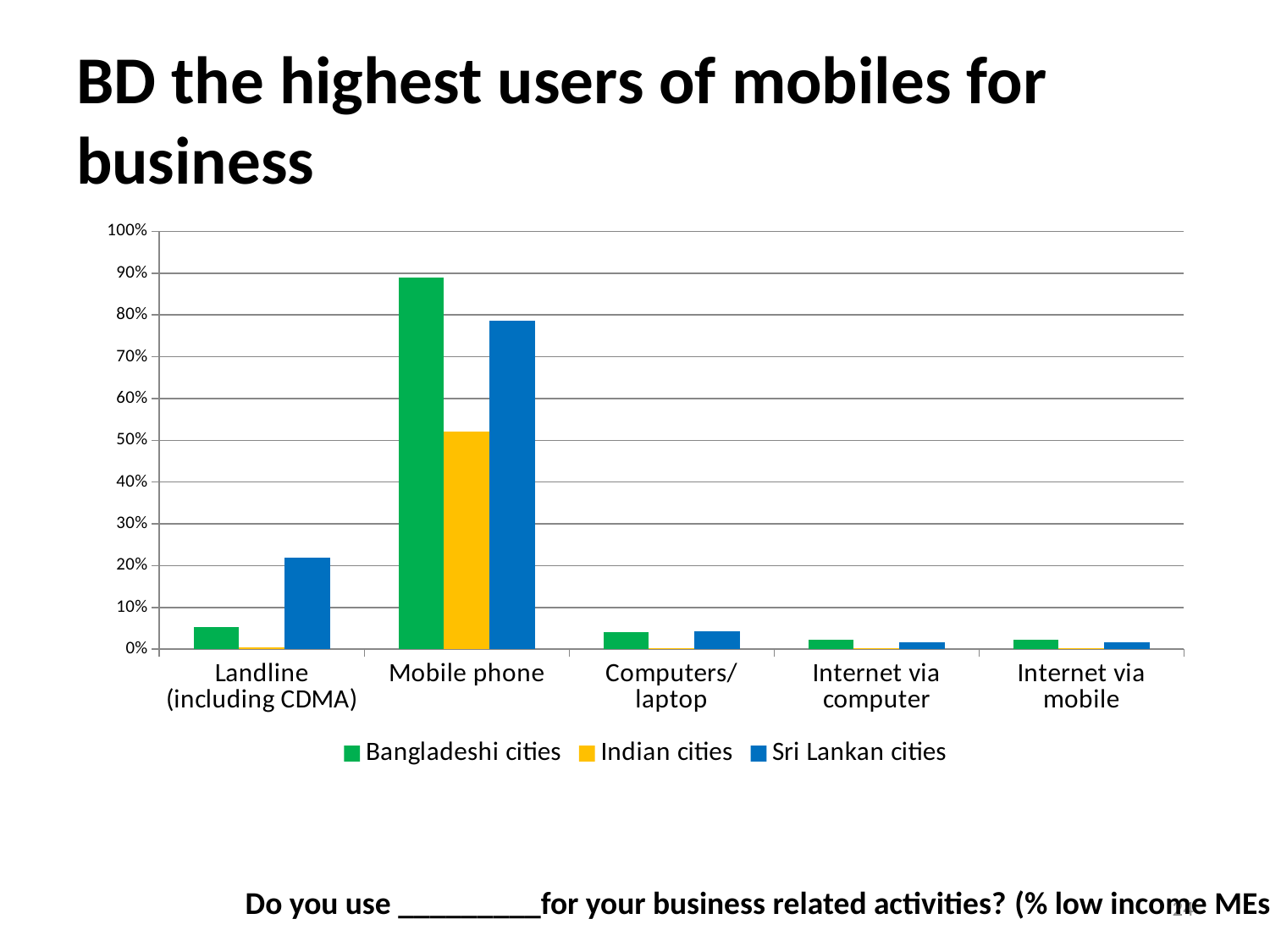
Is the Bangladeshi cities value for Mobile phone greater or less than 80%? greater Is the Indian cities value for Mobile phone greater or less than 60%? less How many series does the legend list? 3 How many categories are shown on the x axis? 5 For Landline (including CDMA), which is larger: Sri Lankan cities or Bangladeshi cities? Sri Lankan cities What colour represents Indian cities in the chart? yellow Is the Sri Lankan cities value for Mobile phone greater or less than 70%? greater For Mobile phone, which is larger: Bangladeshi cities or Sri Lankan cities? Bangladeshi cities What kind of chart is shown on the slide? bar chart For which category is the Bangladeshi cities value highest? Mobile phone Which series has the lowest value for Mobile phone? Indian cities